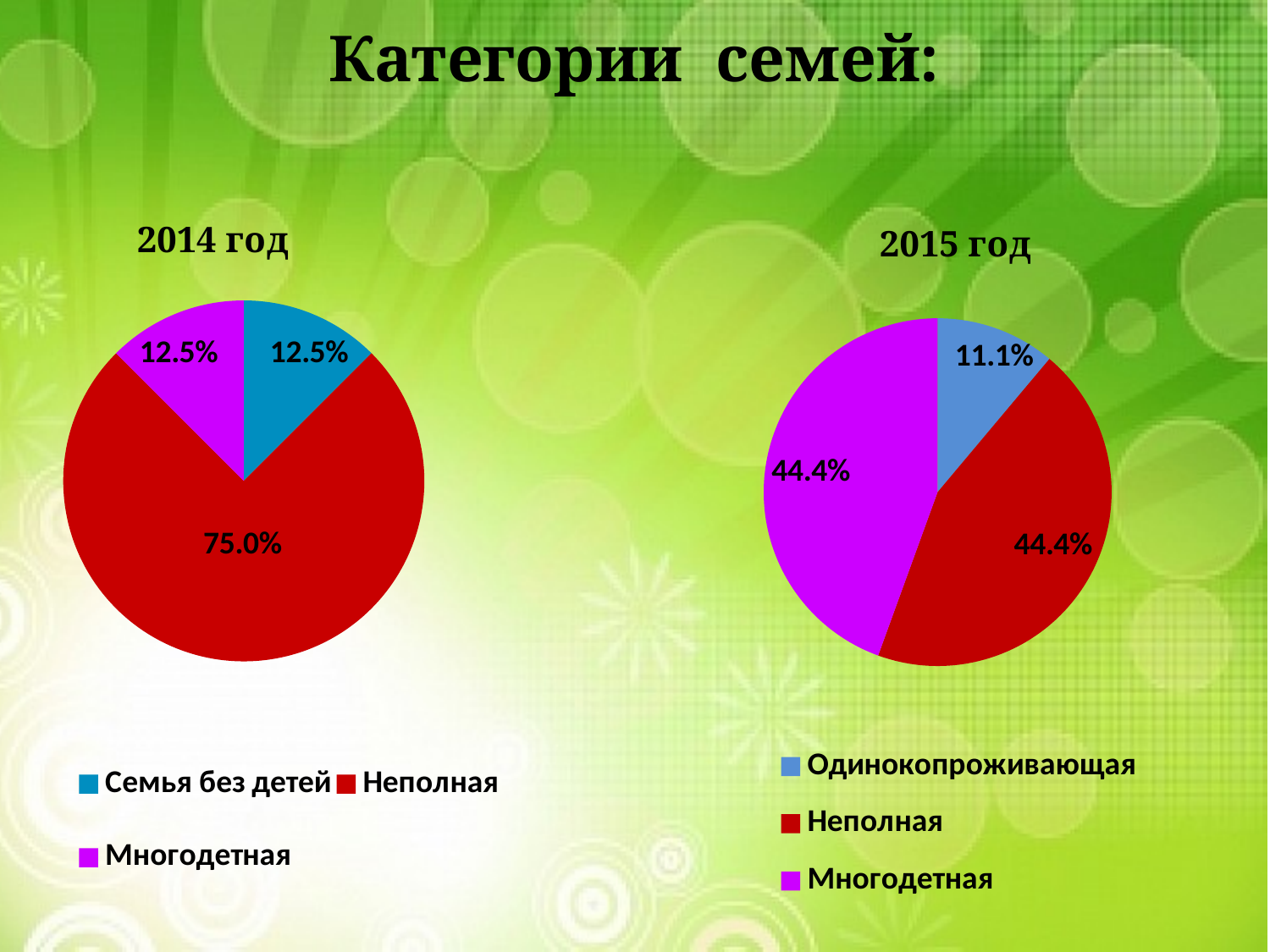
What kind of chart is the 2015 год chart? Pie chart In the 2015 год chart, which category has the smallest slice? Одинокопроживающая In the 2014 год chart, which category has the largest slice? Неполная In the 2015 год chart, what share does Одинокопроживающая have? 11.1% In the 2015 год chart, what is the difference between the Многодетная share and the Одинокопроживающая share? 33.3% In the 2015 год chart, which colour represents Многодетная? Purple In the 2014 год chart, what is the difference between the Неполная share and the Семья без детей share? 62.5% In the 2014 год chart, what share does Неполная have? 75.0% In the 2014 год chart, what share does Многодетная have? 12.5% In the 2015 год chart, which is larger: Неполная or Одинокопроживающая? Неполная In the 2015 год chart, what share does Многодетная have? 44.4% How many slices does the 2014 год chart have? 3